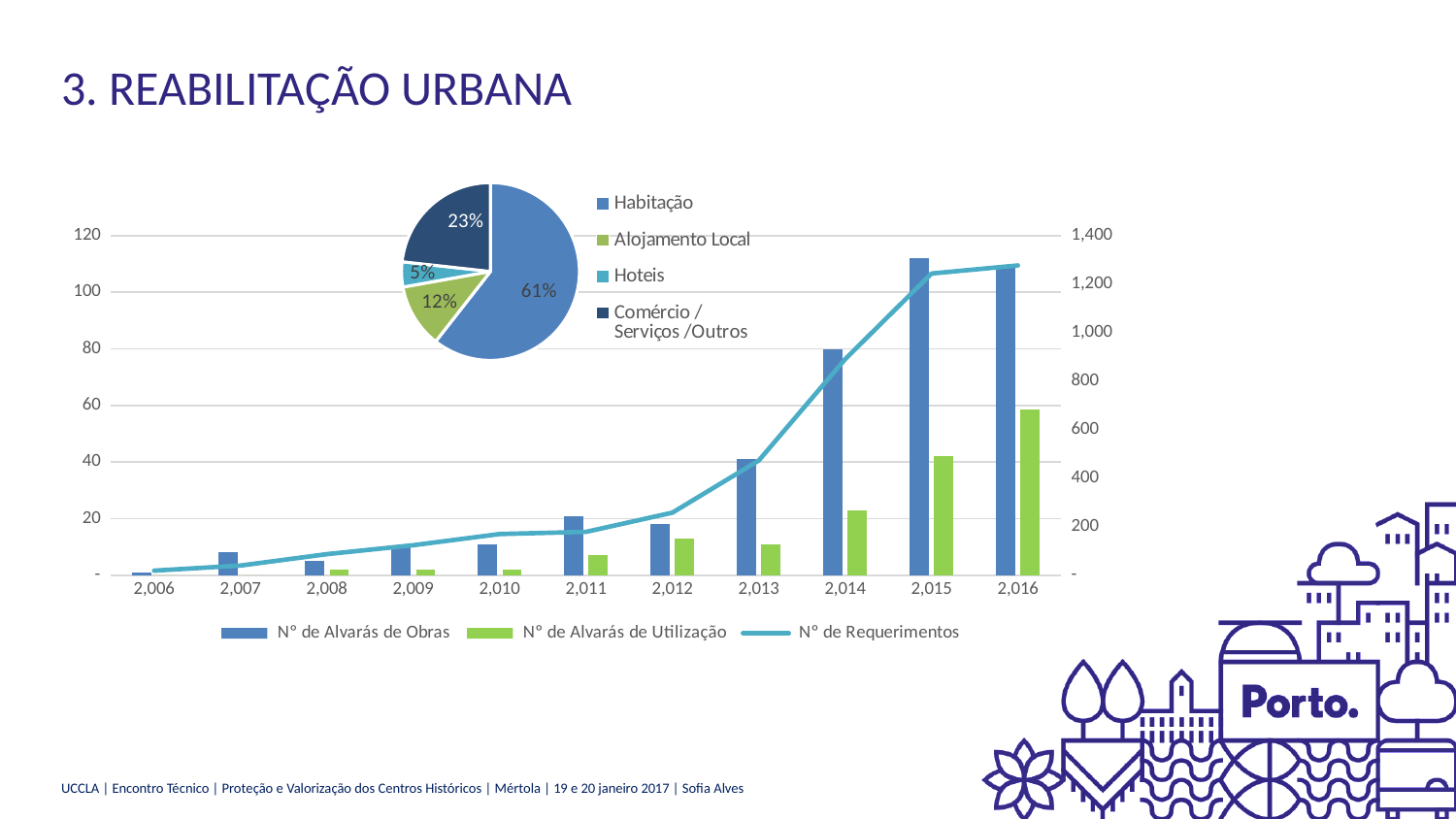
In the bar chart with years on the x axis, which is larger in 2,013: Nº de Alvarás de Obras or Nº de Alvarás de Utilização? Nº de Alvarás de Obras In the bar chart with years on the x axis, how many series does the legend list? 3 In the pie chart, which category has the largest slice? Habitação In the pie chart, how many slices are there? 4 In the bar chart with years on the x axis, is the value for Nº de Alvarás de Utilização in 2,016 greater or less than 40? greater In the pie chart, how many percentage points larger is Habitação than Alojamento Local? 49 In the pie chart, what share does Habitação have? 61% In the bar chart with years on the x axis, does the Nº de Requerimentos line rise or fall from 2,006 to 2,016? rise In the pie chart, which category has the smallest slice? Hoteis In the bar chart with years on the x axis, how many years are shown? 11 In the bar chart with years on the x axis, is the value for Nº de Alvarás de Obras in 2,014 greater or less than 60? greater In the pie chart, what share does Comércio / Serviços /Outros have? 23%